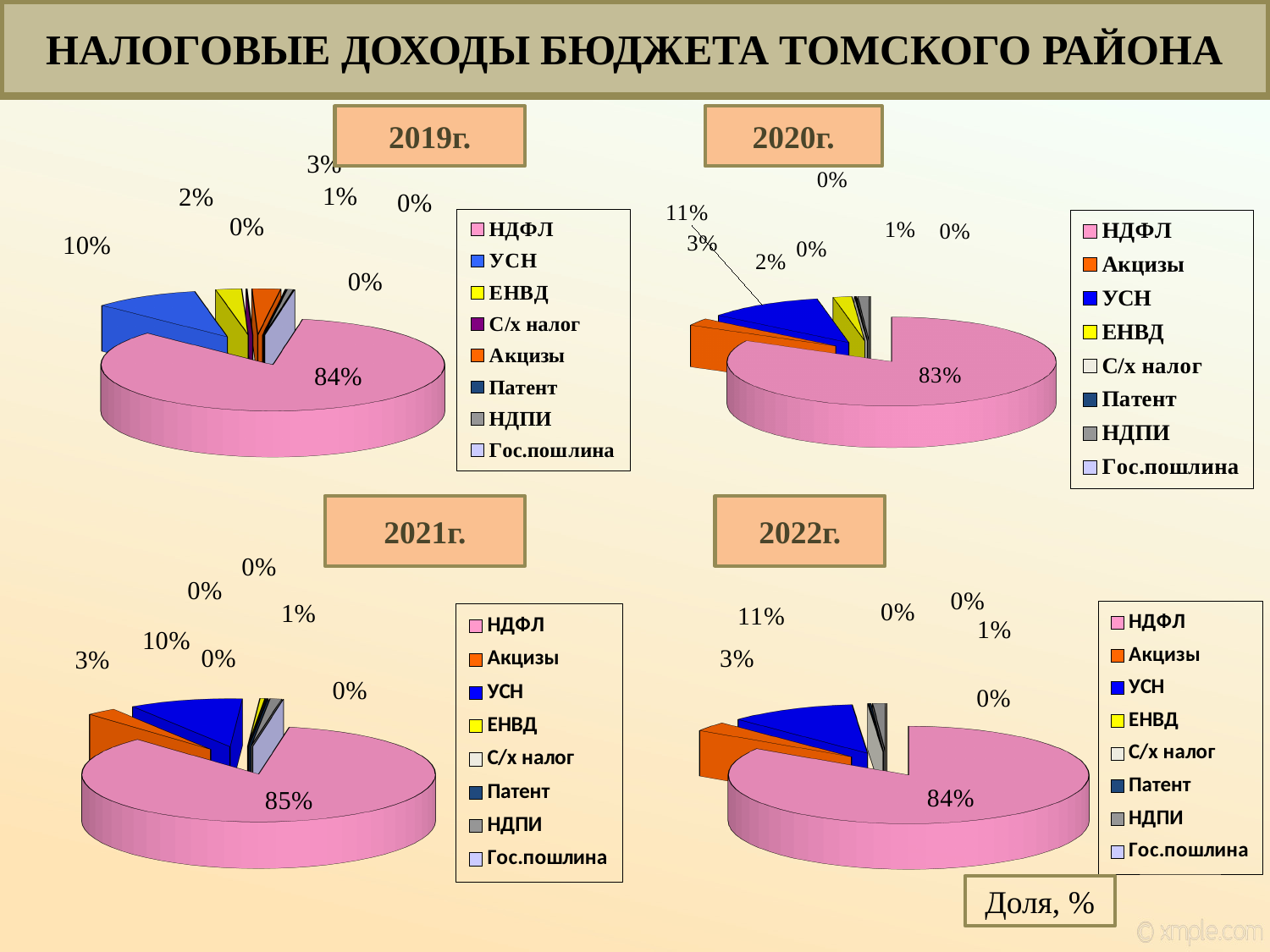
What unit label is shown in the box at the bottom right of the slide? Доля, % In the 2021г. chart, what share is labelled on the largest (pink) slice? 85% In the 2020г. chart, what share is labelled on the largest (pink) slice? 83% What is the first entry in the legend of the 2022г. chart? НДФЛ Which is larger: the НДФЛ share in the 2021г. chart or in the 2020г. chart? 2021г. How many pie charts are shown on the slide? 4 In the 2022г. chart, what share is labelled on the largest (pink) slice? 84% How many entries does the legend of the 2020г. chart list? 8 In the 2021г. chart, which category has the largest share? НДФЛ What is the difference between the НДФЛ share in the 2021г. chart (85%) and in the 2020г. chart (83%)? 2% What kind of chart is used for the 2019г. data? pie chart